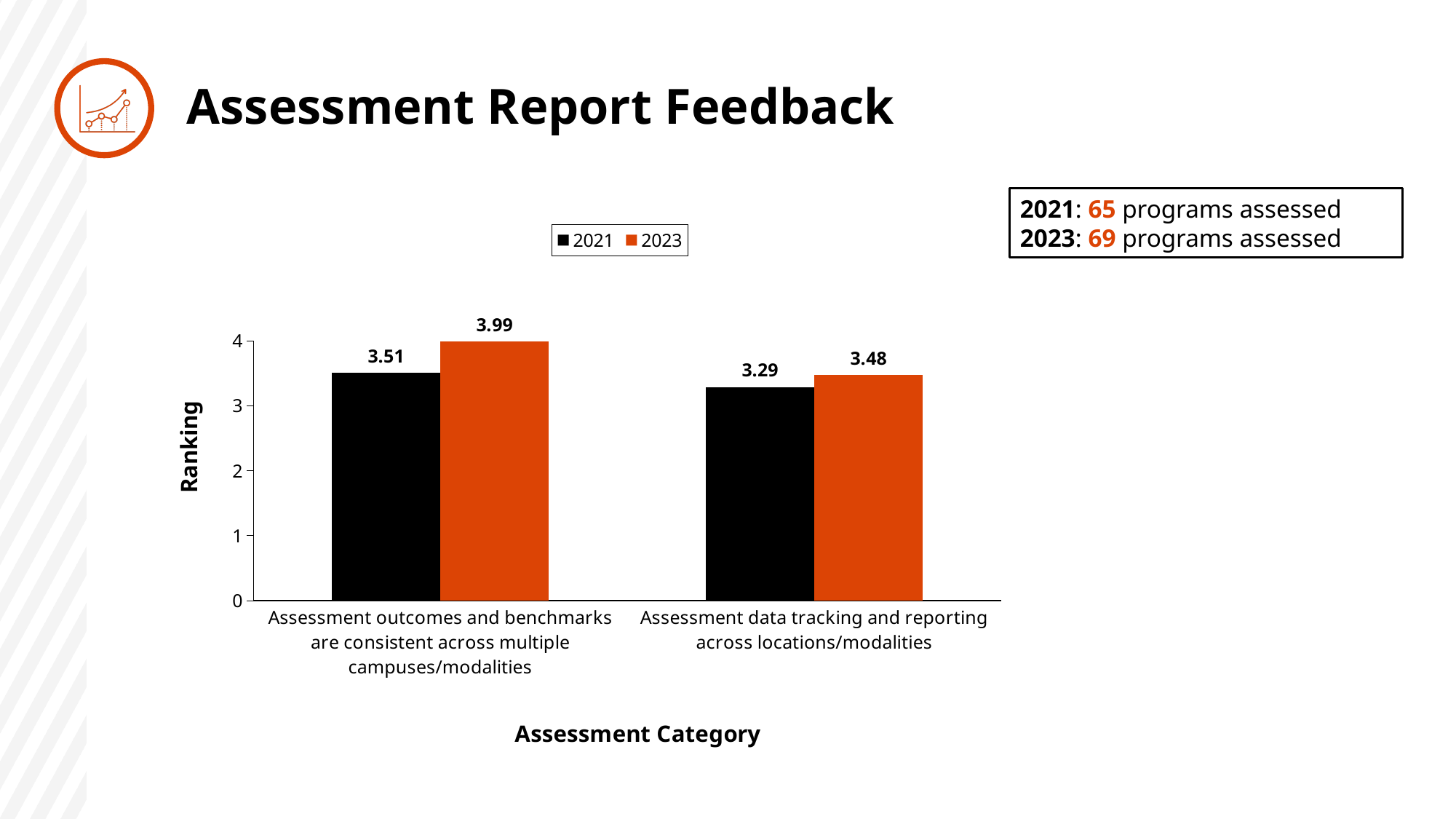
How many series does the legend list? 2 By how much did the ranking for 'Assessment data tracking and reporting across locations/modalities' change from 2021 to 2023? 0.19 Which bar has the highest ranking on the chart? 2023, Assessment outcomes and benchmarks are consistent across multiple campuses/modalities Which year has the higher ranking for 'Assessment data tracking and reporting across locations/modalities'? 2023 What is the 2021 ranking for 'Assessment data tracking and reporting across locations/modalities'? 3.29 How many assessment categories are shown on the x axis? 2 What is the 2023 ranking for 'Assessment outcomes and benchmarks are consistent across multiple campuses/modalities'? 3.99 By how much did the ranking for 'Assessment outcomes and benchmarks are consistent across multiple campuses/modalities' change from 2021 to 2023? 0.48 What is the 2021 ranking for 'Assessment outcomes and benchmarks are consistent across multiple campuses/modalities'? 3.51 Which bar has the lowest ranking on the chart? 2021, Assessment data tracking and reporting across locations/modalities What is the 2023 ranking for 'Assessment data tracking and reporting across locations/modalities'? 3.48 What type of chart is shown on the slide? Bar chart